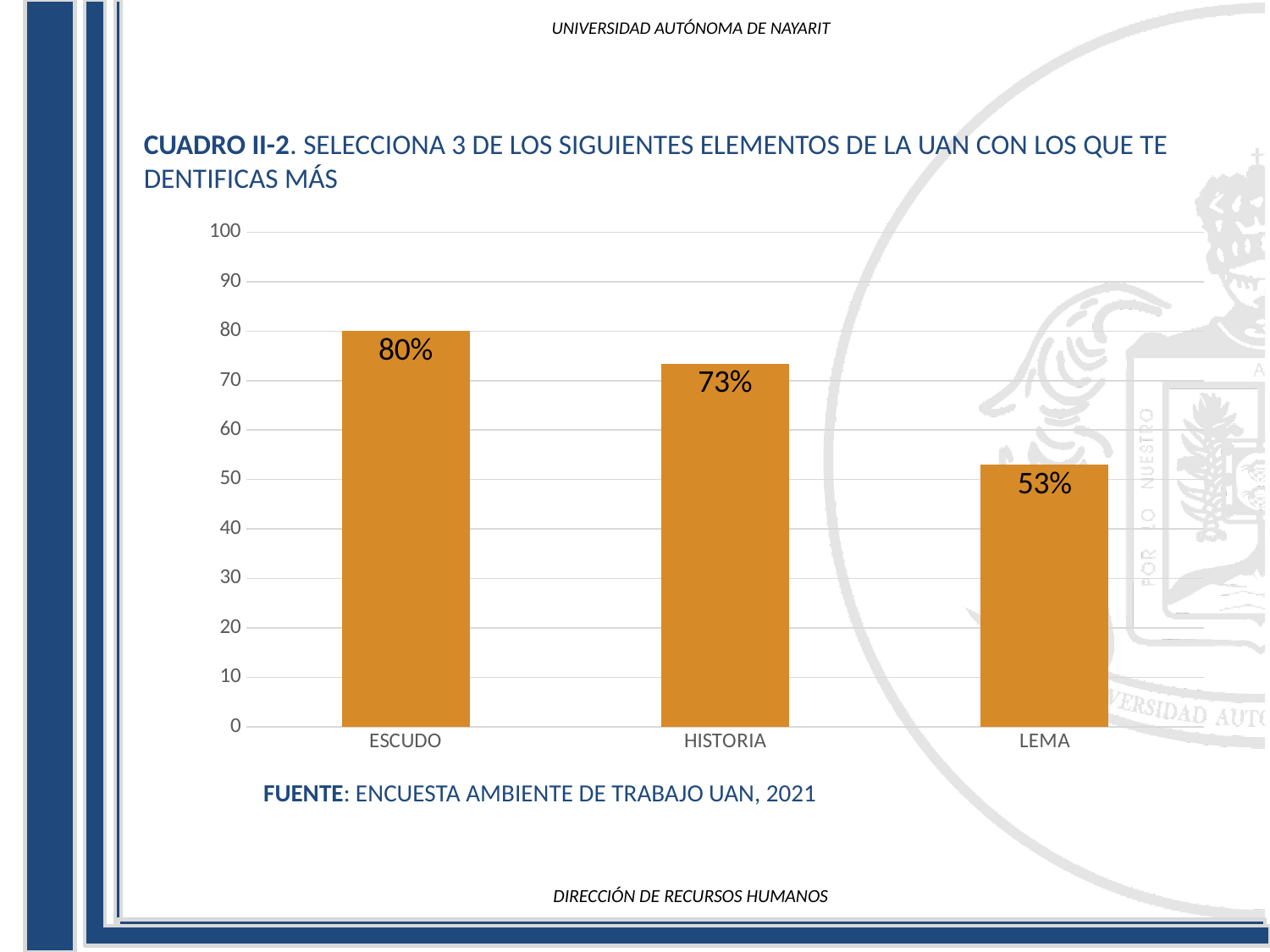
Which category has the lowest value? LEMA How many categories are shown in the chart? 3 What is the value for LEMA? 53% What is the value for HISTORIA? 73% What is the difference between the values for HISTORIA and LEMA? 20% Do the values rise or fall from ESCUDO to LEMA along the x axis? fall What is the difference between the values for ESCUDO and LEMA? 27% What kind of chart is shown on the slide? bar chart What is the value for ESCUDO? 80% Which category has the highest value? ESCUDO Which is larger, the value for HISTORIA or the value for LEMA? HISTORIA Is the value for LEMA greater or less than 60? less